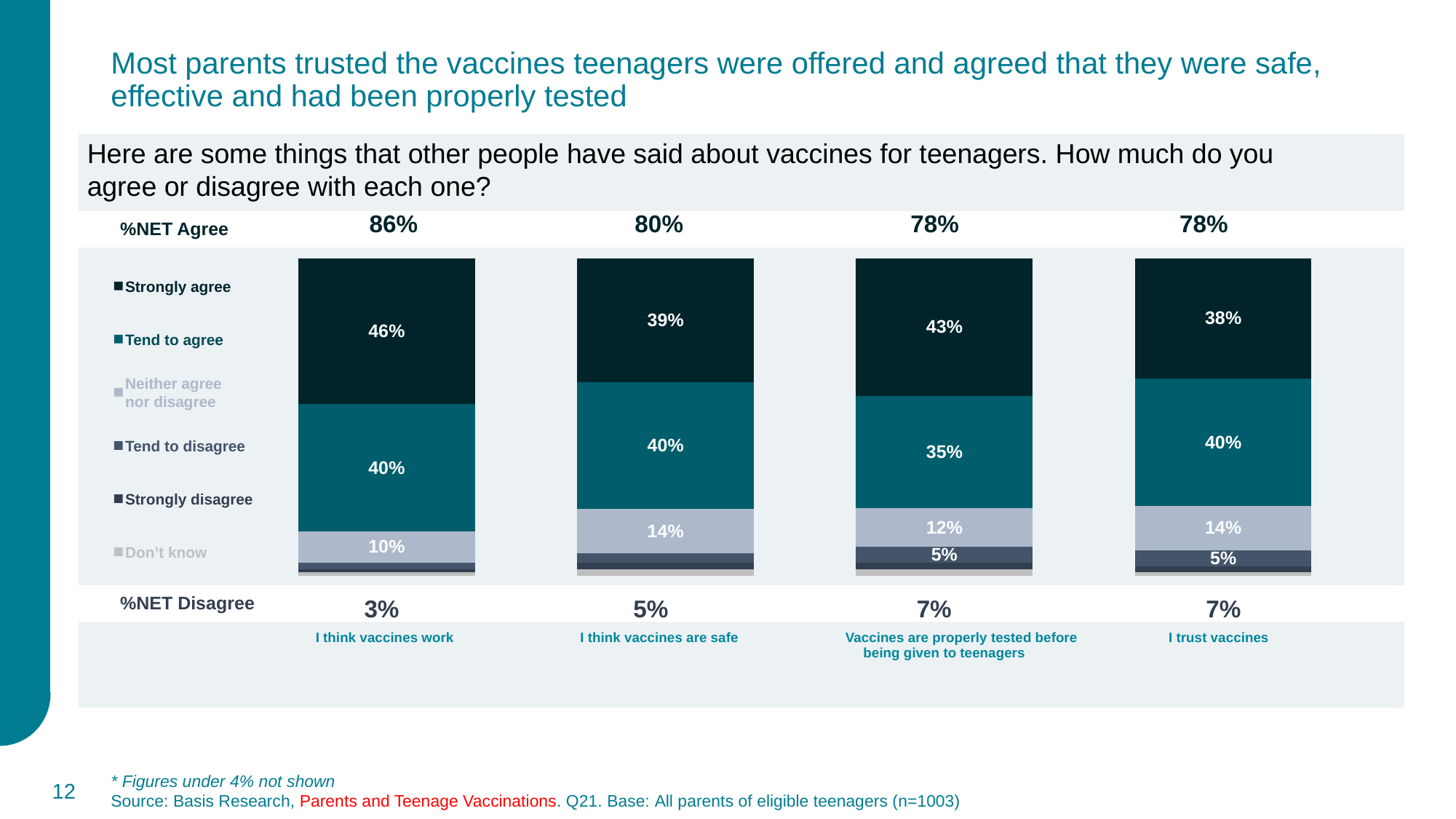
Which statement has the lowest %NET Disagree figure? I think vaccines work What is the %NET Agree figure for "I trust vaccines"? 78% How many response categories does the legend list? 6 Which is larger: the Strongly agree share for "I think vaccines are safe" or for "Vaccines are properly tested before being given to teenagers"? Vaccines are properly tested before being given to teenagers What percentage of parents neither agree nor disagree with "I think vaccines are safe"? 14% Which statement has the highest %NET Agree figure? I think vaccines work What is the difference between the Strongly agree percentages for "I think vaccines work" and "I trust vaccines"? 8 percentage points What percentage of parents tend to agree that vaccines are properly tested before being given to teenagers? 35% What type of chart is shown on the slide? Stacked bar chart How many statements are shown as bars in the chart? 4 What percentage of parents strongly agree with the statement "I think vaccines work"? 46% What is the %NET Disagree figure for "I think vaccines are safe"? 5%